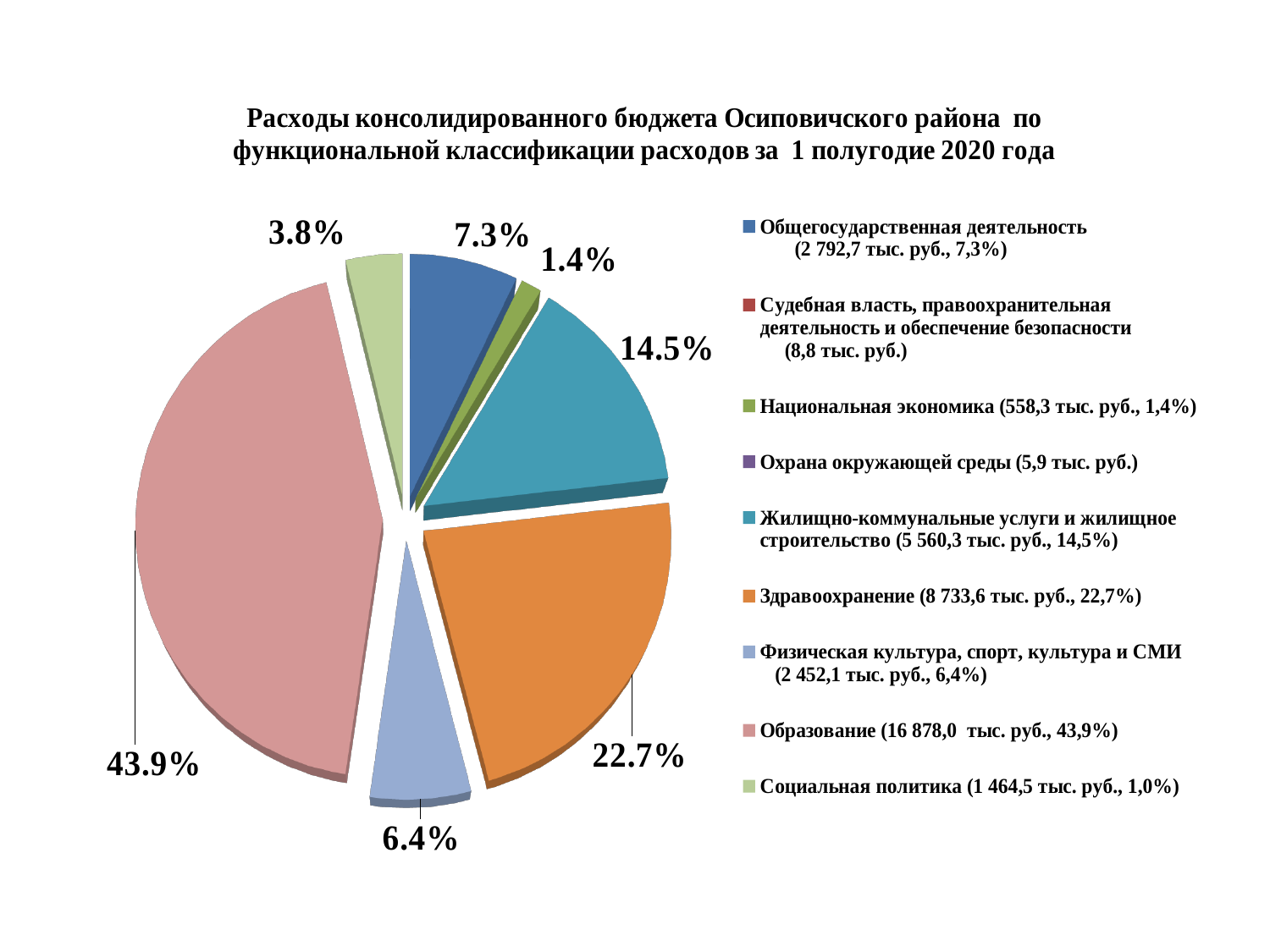
What share of the pie does Общегосударственная деятельность account for? 7.3% How many entries does the legend list? 9 What share of the pie does Жилищно-коммунальные услуги и жилищное строительство account for? 14.5% What colour is the Образование slice of the pie? pink What share of the pie does Образование account for? 43.9% What is the difference in percentage points between the Образование slice and the Здравоохранение slice? 21.2 According to the legend, what amount in тыс. руб. is given for Здравоохранение? 8 733,6 тыс. руб. Which is larger, the slice for Здравоохранение or the slice for Жилищно-коммунальные услуги и жилищное строительство? Здравоохранение What kind of chart is shown on the slide? pie chart Which category has the largest slice of the pie? Образование